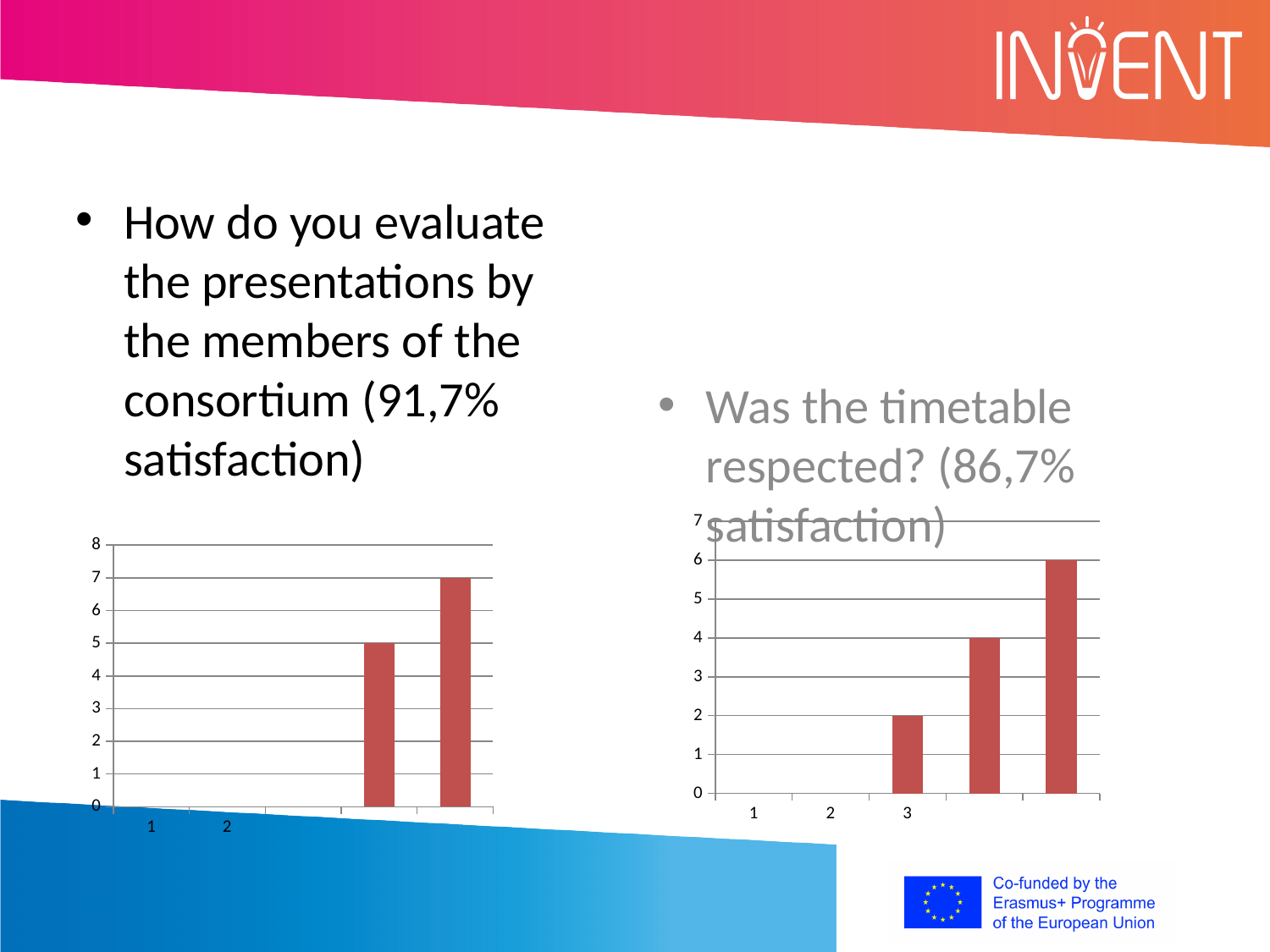
In the chart on the left, is the value of the tallest bar greater or less than 6? greater In the chart on the left, what is the difference between the two visible bars? 2 In the chart on the right, what is the value for category 3? 2 What kind of chart is the chart on the left of the slide? bar chart How many bars are visible in the chart on the left? 2 In the chart on the right, what is the value of the tallest bar? 6 In the chart on the right, what is the difference between the tallest bar and the shortest bar? 4 In the chart on the right, what is the value of the shortest visible bar? 2 What kind of chart is the chart on the right of the slide? bar chart In the chart on the right, do the bar values rise or fall from left to right? rise In the chart on the left, what is the value of the tallest bar? 7 How many bars are visible in the chart on the right? 3